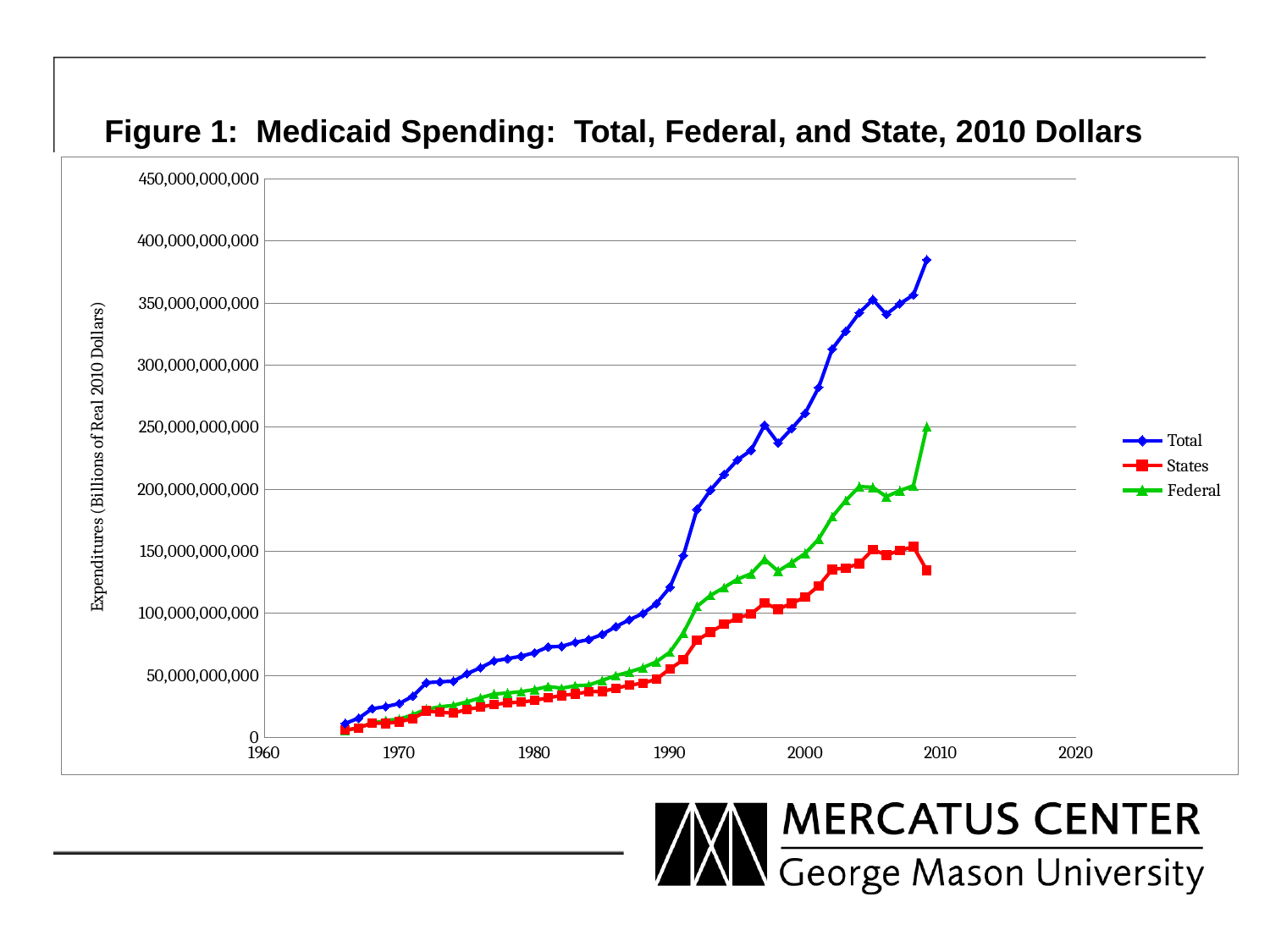
What are the three series named in the legend? Total, States, Federal Which series has the highest values throughout the chart? Total What is the title of the chart? Figure 1: Medicaid Spending: Total, Federal, and State, 2010 Dollars Which series has the lowest values in the 2000s? States Is the value of the Total series in 2009 greater or less than 350,000,000,000? greater Is the value of the Federal series in 1980 greater or less than 50,000,000,000? less Is the value of the Total series in 1990 greater or less than 100,000,000,000? greater In 2005, which is larger, the Federal value or the States value? Federal How many series does the legend list? 3 Does the Total series generally rise or fall from 1966 to 2009? rise What kind of chart is shown on the slide? line chart